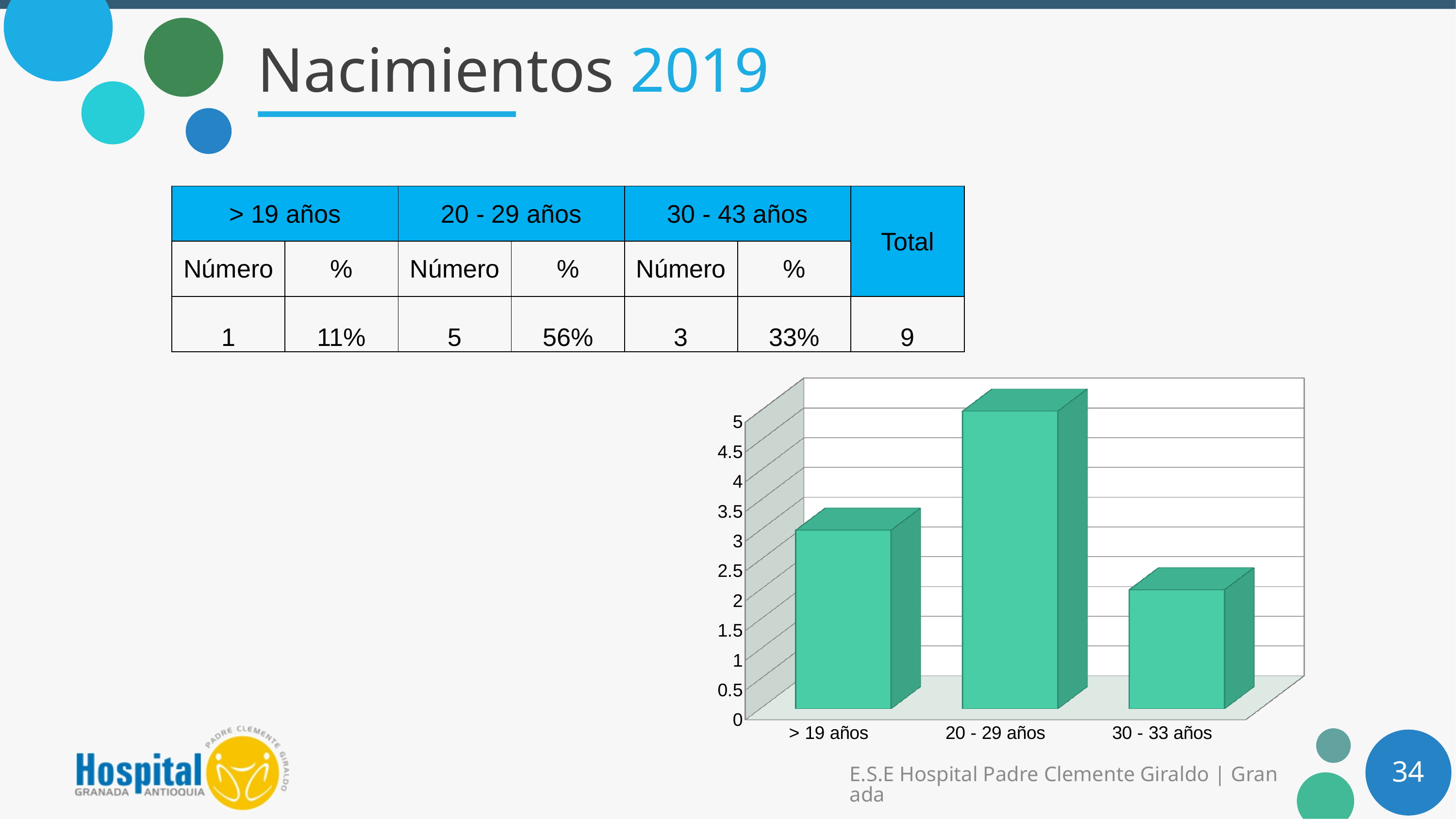
Is the value for "> 19 años" in the chart greater or less than 2? greater Does the bar height rise or fall from "> 19 años" to "20 - 29 años"? rise Which category has the tallest bar in the chart? 20 - 29 años Is the value for "30 - 33 años" in the chart greater or less than 3? less In the chart, which bar is taller: "20 - 29 años" or "> 19 años"? 20 - 29 años In the chart, which bar is taller: "> 19 años" or "30 - 33 años"? > 19 años Which category has the shortest bar in the chart? 30 - 33 años What kind of chart is shown on the slide? bar chart How many categories are shown on the x axis of the chart? 3 Does the bar height rise or fall from "20 - 29 años" to "30 - 33 años"? fall Is the value for "20 - 29 años" in the chart greater or less than 4? greater What is the highest tick value shown on the chart's vertical axis? 5